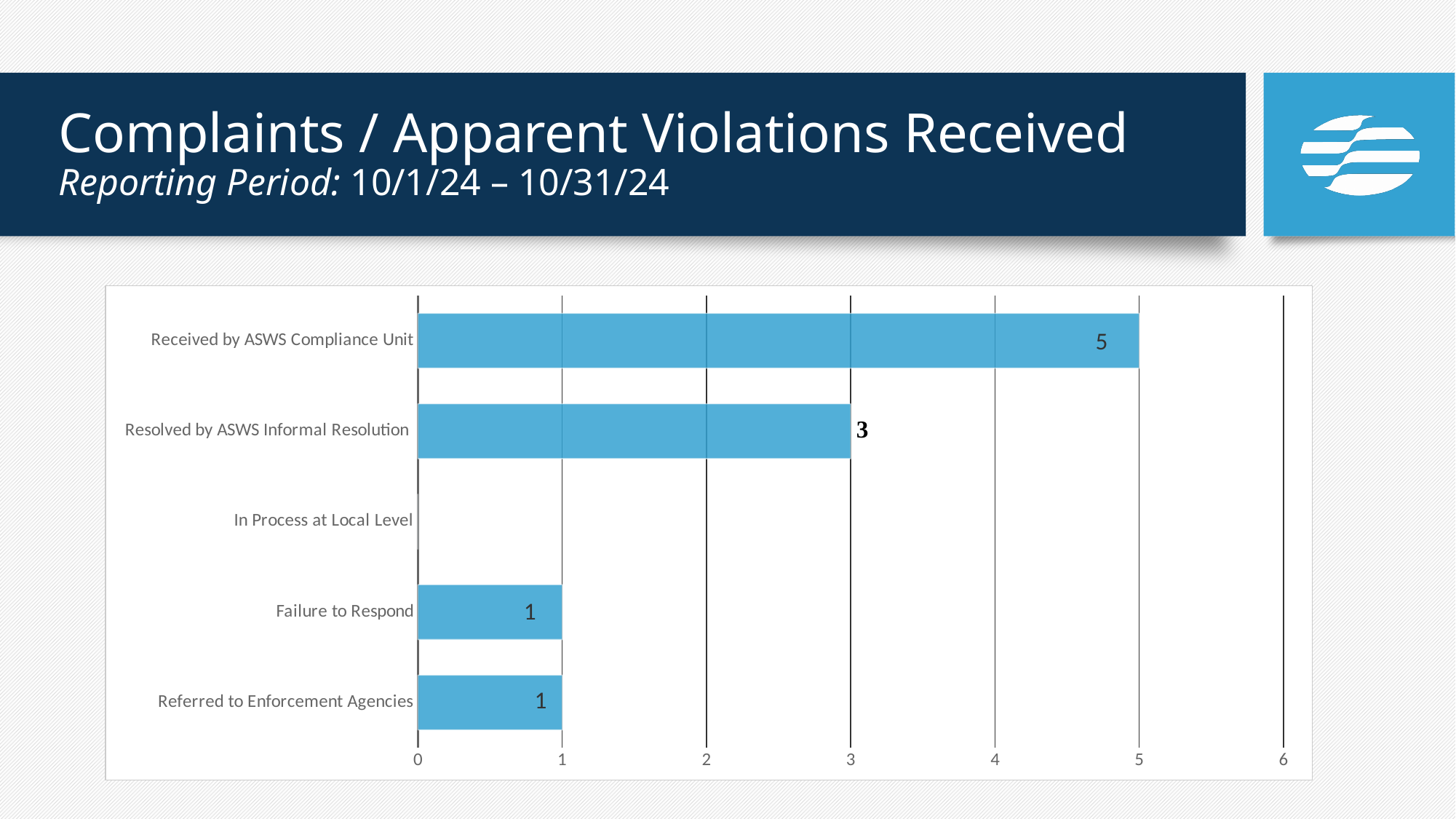
Is the value for Received by ASWS Compliance Unit greater or less than 4? greater Which category has the highest value? Received by ASWS Compliance Unit What is the difference between Received by ASWS Compliance Unit and Resolved by ASWS Informal Resolution? 2 What is the value for Failure to Respond? 1 What is the value for Received by ASWS Compliance Unit? 5 What reporting period is given in the slide title? 10/1/24 – 10/31/24 How many categories are shown on the chart? 5 What kind of chart is shown on the slide? bar chart What is the value for Referred to Enforcement Agencies? 1 What is the value for Resolved by ASWS Informal Resolution? 3 What is the highest value shown on the x axis? 6 Which is larger, Resolved by ASWS Informal Resolution or Failure to Respond? Resolved by ASWS Informal Resolution